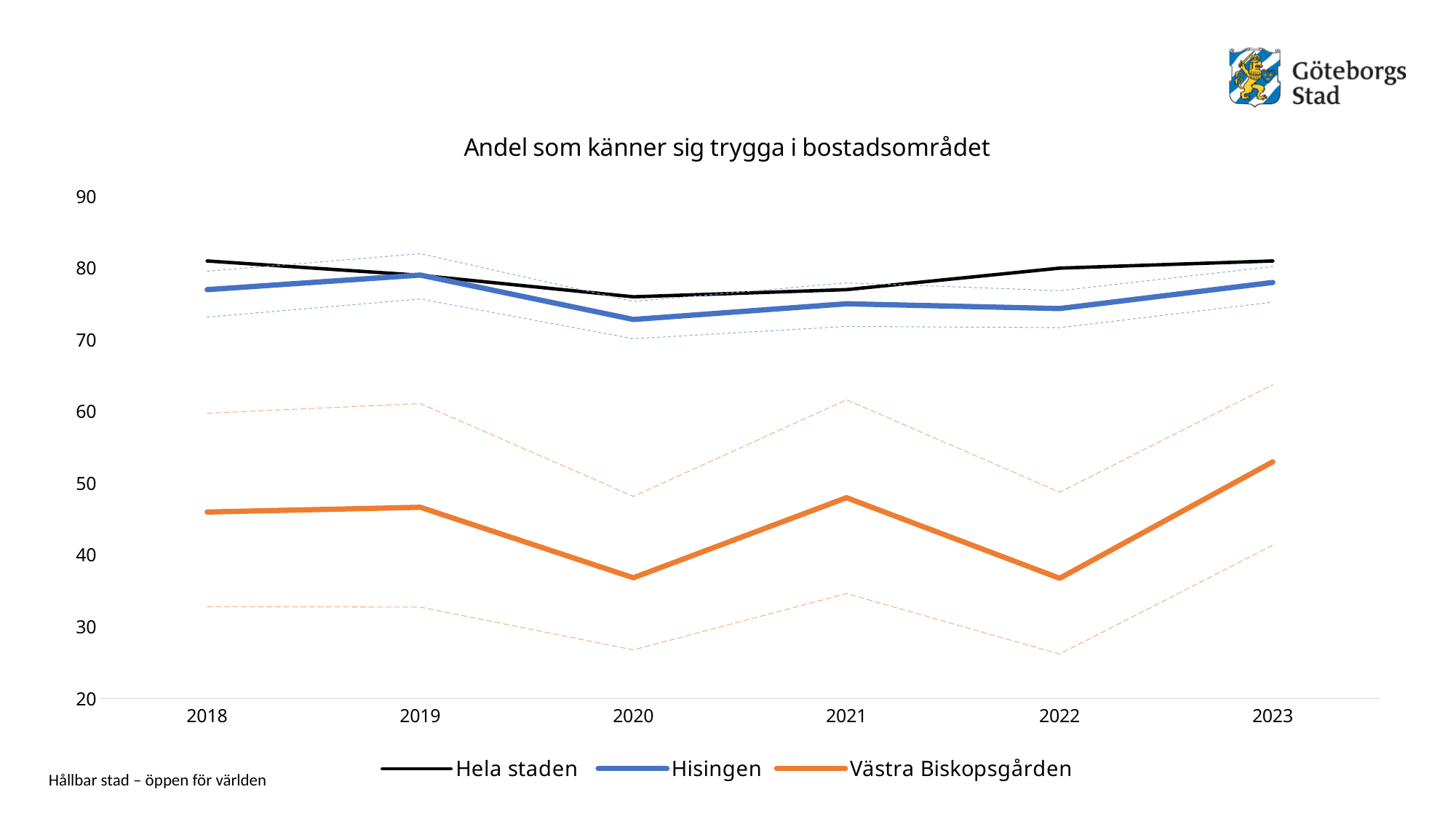
Is the value for Västra Biskopsgården in 2020 greater or less than 40? less Which is larger in 2020, the value for Hela staden or for Västra Biskopsgården? Hela staden What is the title of the chart? Andel som känner sig trygga i bostadsområdet In which year is the value for Hisingen lowest? 2020 Is the value for Västra Biskopsgården in 2023 greater or less than 50? greater Is the value for Hisingen in 2020 greater or less than 70? greater Does the value for Västra Biskopsgården rise or fall from 2022 to 2023? rise How many years are shown on the x axis? 6 What colour is the line for Västra Biskopsgården? orange How many series does the legend list? 3 What kind of chart is shown on the slide? line chart In which year is the value for Västra Biskopsgården highest? 2023